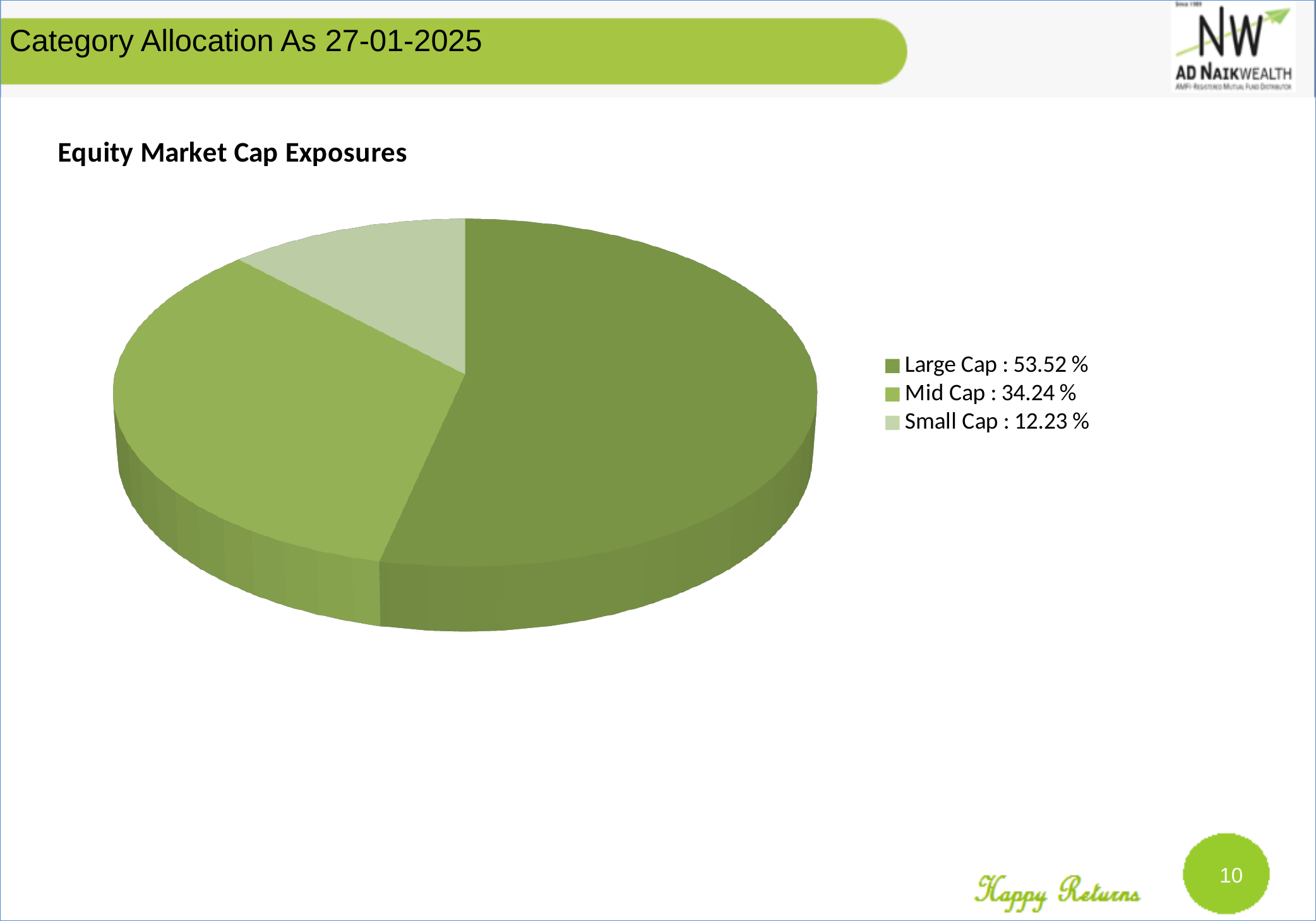
What is the difference between the Mid Cap and Small Cap values? 22.01 % Which category has the largest share of the pie? Large Cap Which category is shown in the lightest green colour? Small Cap How many categories does the pie chart show? 3 What is the title of the chart? Equity Market Cap Exposures What is the value for Large Cap? 53.52 % What is the value for Mid Cap? 34.24 % Which category has the smallest share of the pie? Small Cap What is the difference between the Large Cap and Mid Cap values? 19.28 % What is the value for Small Cap? 12.23 % Which is larger, Mid Cap or Small Cap? Mid Cap What kind of chart is shown on the slide? pie chart